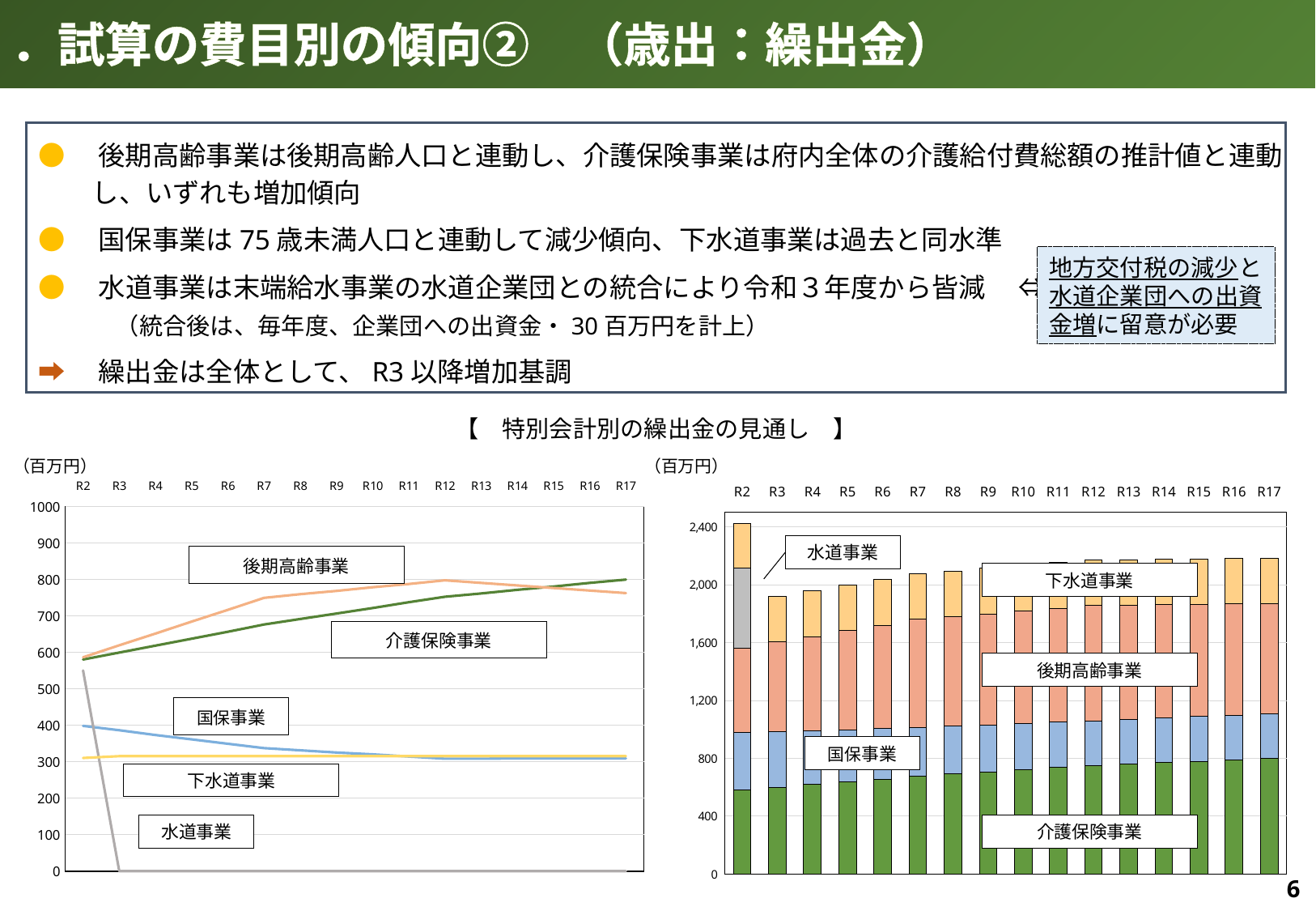
In the left chart, is the value for 下水道事業 at R10 greater or less than 400? less What kind of chart is the chart on the left side of the slide? line chart In the left chart, which series has the lowest value at R17? 水道事業 In the left chart, does the 介護保険事業 line rise or fall from R2 to R17? rise In the left chart, is the value for 介護保険事業 at R2 greater or less than 500? greater In the right chart, which fiscal year has the tallest stacked bar? R2 In the left chart, how many fiscal years (points) are shown on the x axis? 16 In the right chart, how many stacked bars are there? 16 In the left chart, is the value for 水道事業 at R2 greater or less than 500? greater In the left chart, how many series (lines) are labelled? 5 What kind of chart is the chart on the right side of the slide? stacked bar chart In the left chart, does the 国保事業 line rise or fall from R2 to R17? fall